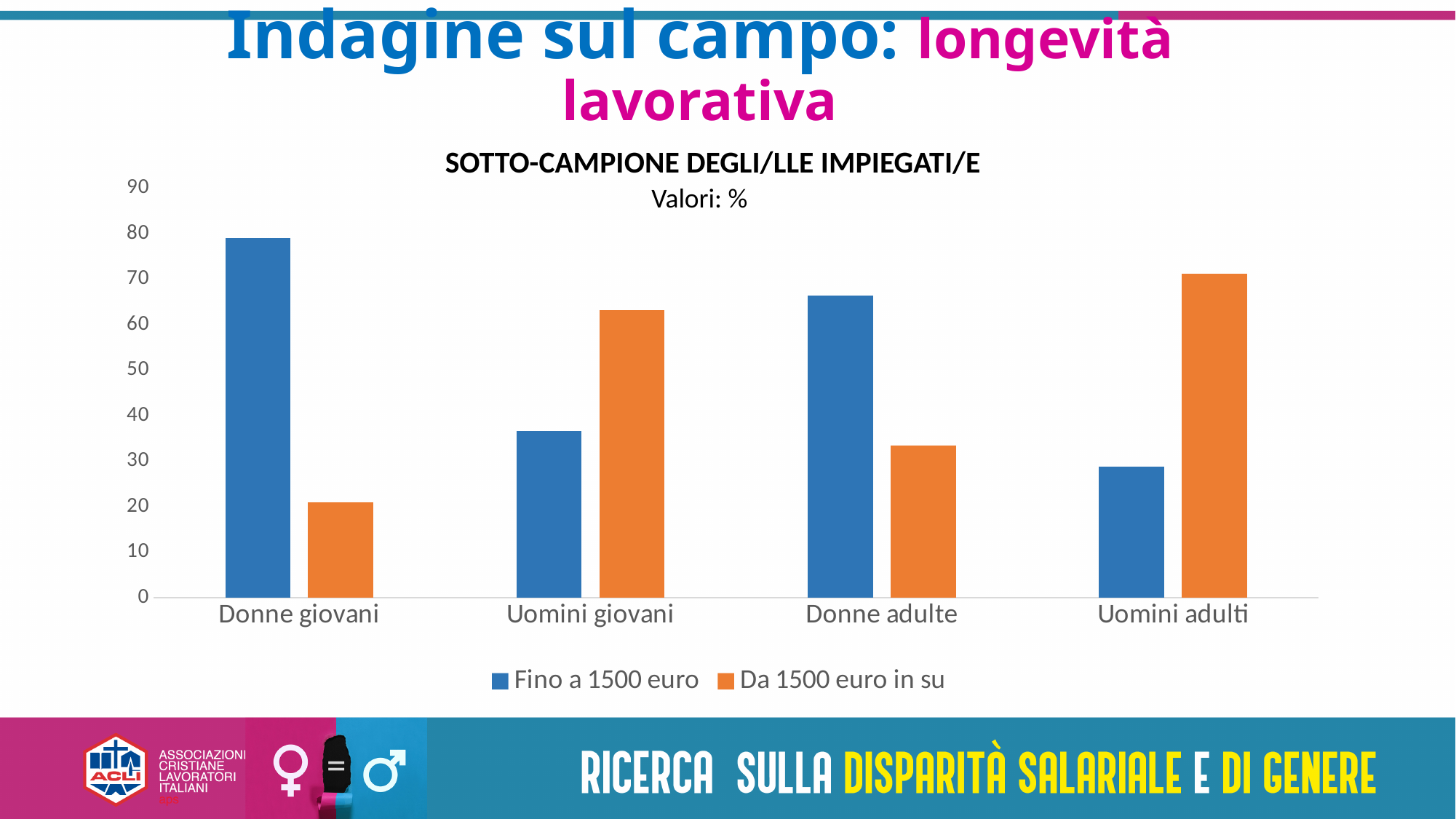
Is the value for 'Da 1500 euro in su' for Uomini giovani greater or less than 60? greater Which category has the lowest value for the 'Fino a 1500 euro' series? Uomini adulti How many categories are shown on the x axis of the chart? 4 Which category has the highest value for the 'Fino a 1500 euro' series? Donne giovani For Donne adulte, which series has the larger value: 'Fino a 1500 euro' or 'Da 1500 euro in su'? Fino a 1500 euro Is the value for 'Fino a 1500 euro' for Donne giovani greater or less than 70? greater How many series does the chart legend list? 2 What kind of chart is shown on the slide? bar chart Is the value for 'Fino a 1500 euro' for Uomini adulti greater or less than 40? less Which category has the lowest value for the 'Da 1500 euro in su' series? Donne giovani What is the subtitle printed above the chart, below the main title? SOTTO-CAMPIONE DEGLI/LLE IMPIEGATI/E Which category has the highest value for the 'Da 1500 euro in su' series? Uomini adulti